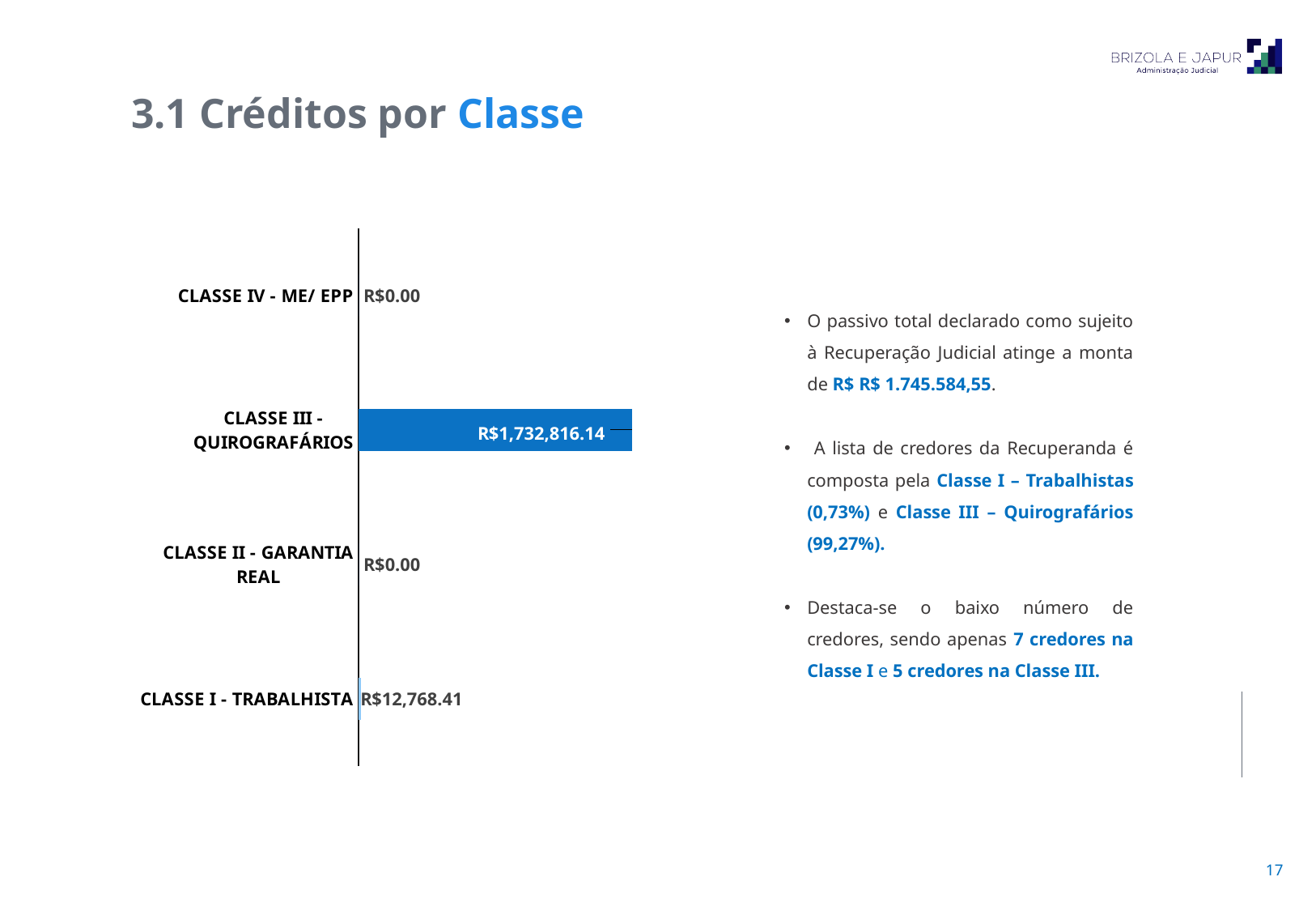
How many classes in the chart have a value of R$0.00? 2 What is the value for CLASSE I - TRABALHISTA? R$12,768.41 What is the title of the slide containing the chart? 3.1 Créditos por Classe What is the value for CLASSE IV - ME/ EPP? R$0.00 What is the value for CLASSE II - GARANTIA REAL? R$0.00 Which class has the highest value in the chart? CLASSE III - QUIROGRAFÁRIOS What colour is the bar for CLASSE III - QUIROGRAFÁRIOS? Blue What kind of chart is shown on the slide? Bar chart How many classes are shown in the chart? 4 What is the difference between the values for CLASSE III - QUIROGRAFÁRIOS and CLASSE I - TRABALHISTA? R$1,720,047.73 Which is larger, the value for CLASSE I - TRABALHISTA or the value for CLASSE III - QUIROGRAFÁRIOS? CLASSE III - QUIROGRAFÁRIOS What is the value for CLASSE III - QUIROGRAFÁRIOS? R$1,732,816.14